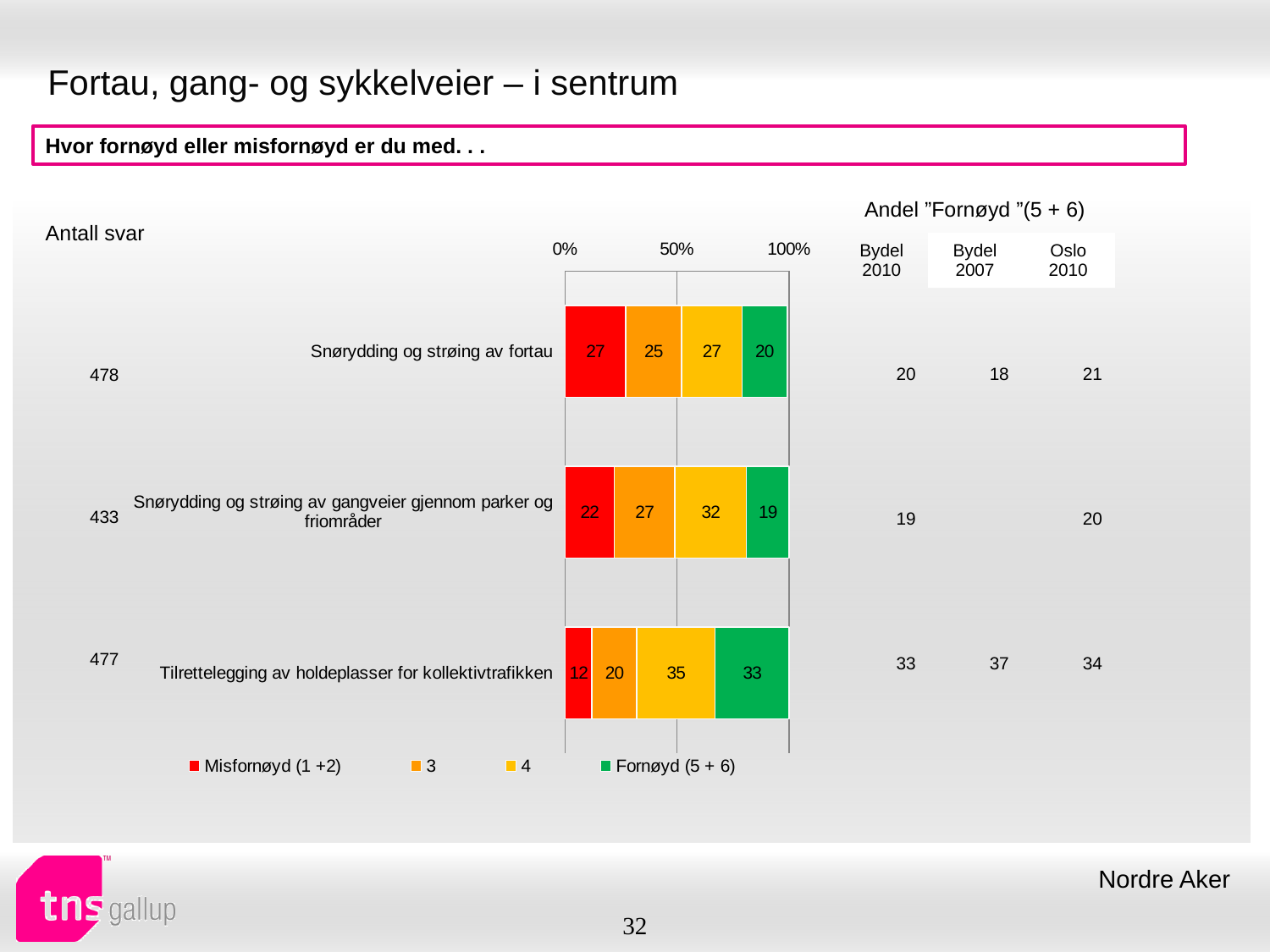
What is the value of the '4' segment for 'Snørydding og strøing av gangveier gjennom parker og friområder'? 32 What is the first entry in the chart legend? Misfornøyd (1 +2) What is the value of the 'Misfornøyd (1 +2)' segment for 'Snørydding og strøing av fortau'? 27 What is the value of the 'Fornøyd (5 + 6)' segment for 'Tilrettelegging av holdeplasser for kollektivtrafikken'? 33 What kind of chart is shown on the slide? Stacked bar chart Which category has the lowest 'Misfornøyd (1 +2)' value? Tilrettelegging av holdeplasser for kollektivtrafikken Which is larger: the '3' segment for 'Snørydding og strøing av fortau' or the '3' segment for 'Snørydding og strøing av gangveier gjennom parker og friområder'? Snørydding og strøing av gangveier gjennom parker og friområder What is the difference between the 'Misfornøyd (1 +2)' values for 'Snørydding og strøing av fortau' and 'Tilrettelegging av holdeplasser for kollektivtrafikken'? 15 What is the total of the stacked bar for 'Snørydding og strøing av gangveier gjennom parker og friområder'? 100 Which category has the highest 'Fornøyd (5 + 6)' value? Tilrettelegging av holdeplasser for kollektivtrafikken How many series does the chart legend list? 4 How many categories are plotted in the bar chart? 3